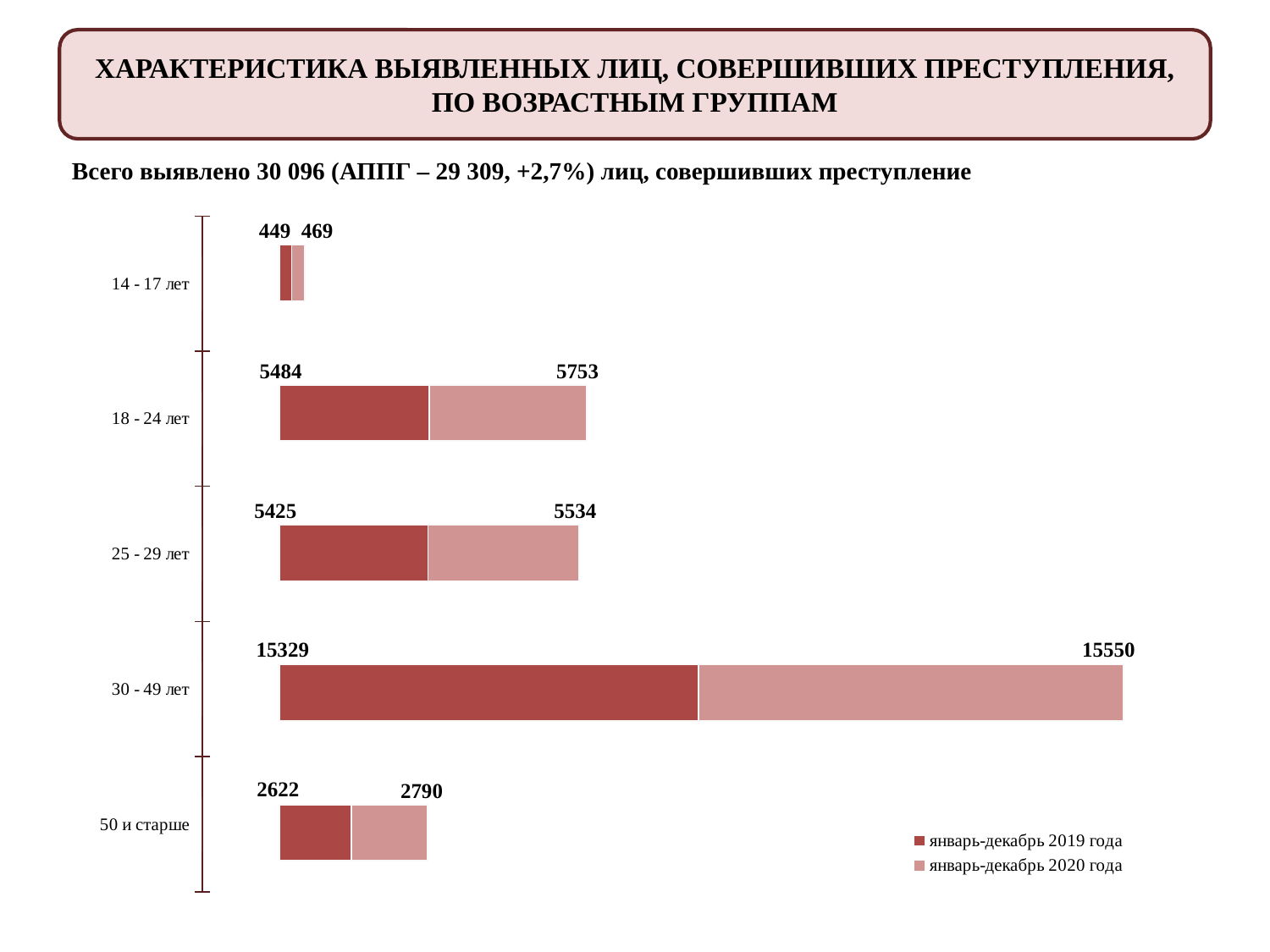
Which is larger for the 25 - 29 лет group: the value for январь-декабрь 2019 года or январь-декабрь 2020 года? январь-декабрь 2020 года What is the difference between the 2020 and 2019 values for the 18 - 24 лет group? 269 How many series does the legend list? 2 What is the total of the two series for the 50 и старше bar? 5412 How many age groups are shown on the chart? 5 What is the value for the 30 - 49 лет group for январь-декабрь 2020 года? 15550 Which series is shown in the darker red colour in the legend? январь-декабрь 2019 года What is the value for the 50 и старше group for январь-декабрь 2020 года? 2790 Which age group has the highest value for январь-декабрь 2019 года? 30 - 49 лет Which age group has the lowest value for январь-декабрь 2020 года? 14 - 17 лет What is the value for the 14 - 17 лет group for январь-декабрь 2019 года? 449 What type of chart is shown on the slide? bar chart